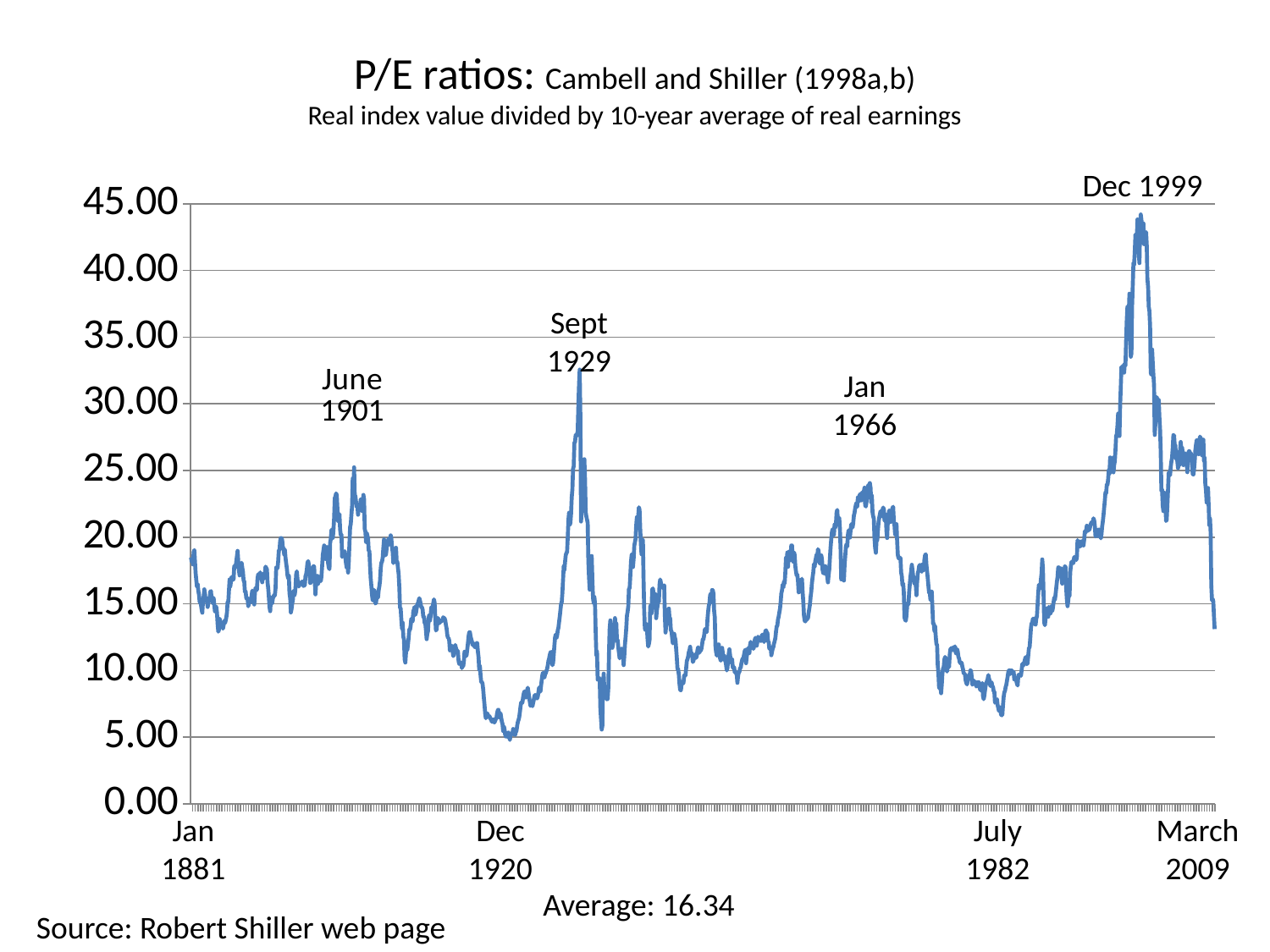
Is the P/E ratio at the June 1901 peak greater or less than 20.00? greater What is the source given for the chart data? Robert Shiller web page Is the P/E ratio at the end of the series (March 2009) greater or less than 15.00? less Which peak is higher, June 1901 or Dec 1999? Dec 1999 What kind of chart is shown on the slide? line chart Is the P/E ratio at the Sept 1929 peak greater or less than 30.00? greater Which peak is higher, Sept 1929 or Jan 1966? Sept 1929 What average P/E ratio is stated below the chart? 16.34 Which of the four labelled peaks (June 1901, Sept 1929, Jan 1966, Dec 1999) has the highest P/E ratio? Dec 1999